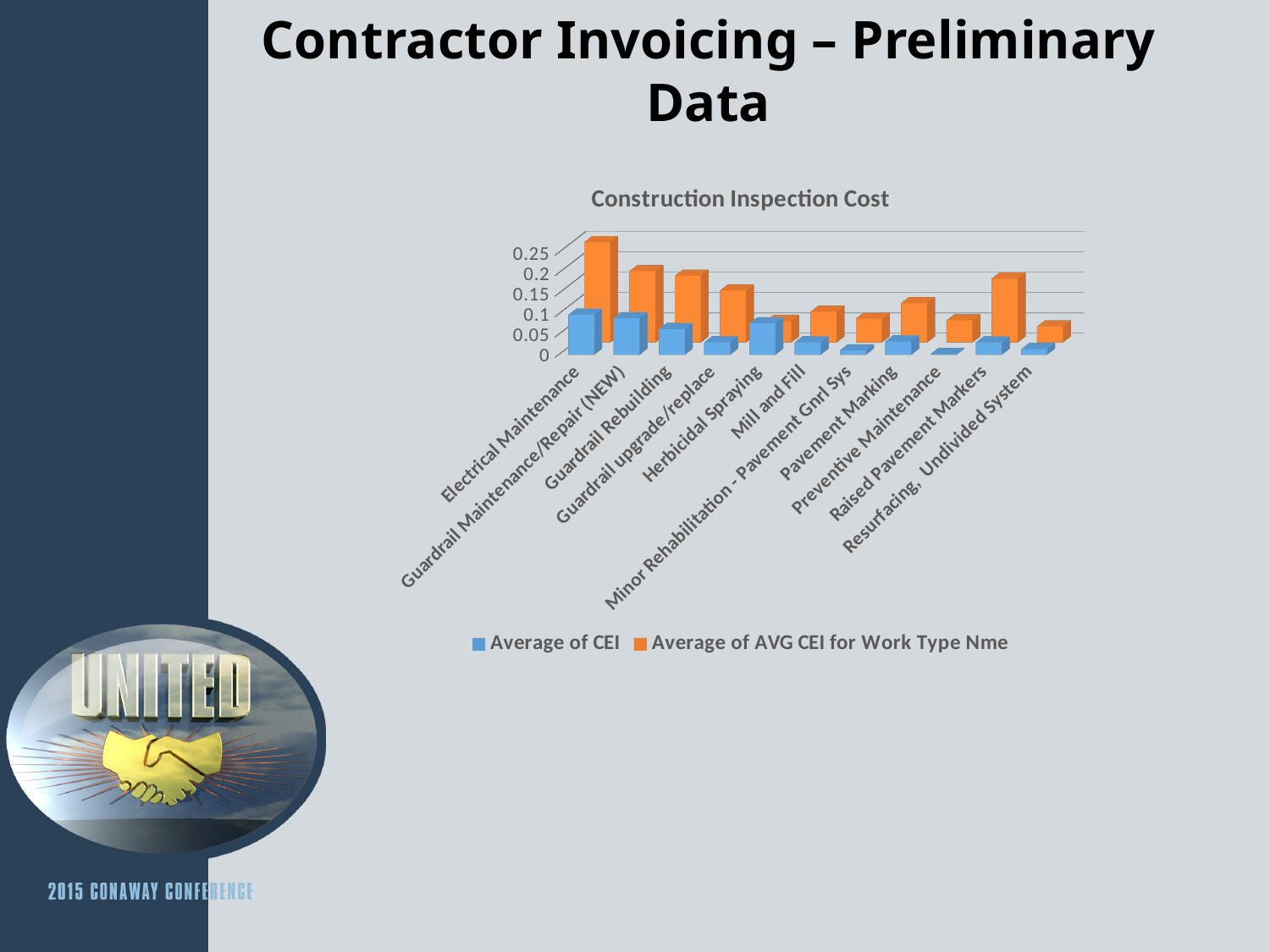
How many work type categories are plotted along the x axis? 11 Is the Average of AVG CEI for Work Type Nme value for Electrical Maintenance greater or less than 0.2? greater How many series does the chart's legend list? 2 Is the Average of AVG CEI for Work Type Nme value for Raised Pavement Markers greater or less than 0.1? greater Which category has the highest value for the Average of AVG CEI for Work Type Nme series? Electrical Maintenance What is the title of the chart? Construction Inspection Cost Which colour represents the Average of CEI series in the legend? blue Is the Average of CEI value for Guardrail upgrade/replace greater or less than 0.05? less For Electrical Maintenance, which series has the larger value: Average of CEI or Average of AVG CEI for Work Type Nme? Average of AVG CEI for Work Type Nme For Raised Pavement Markers, which series has the larger value: Average of CEI or Average of AVG CEI for Work Type Nme? Average of AVG CEI for Work Type Nme What kind of chart is shown on the slide? bar chart